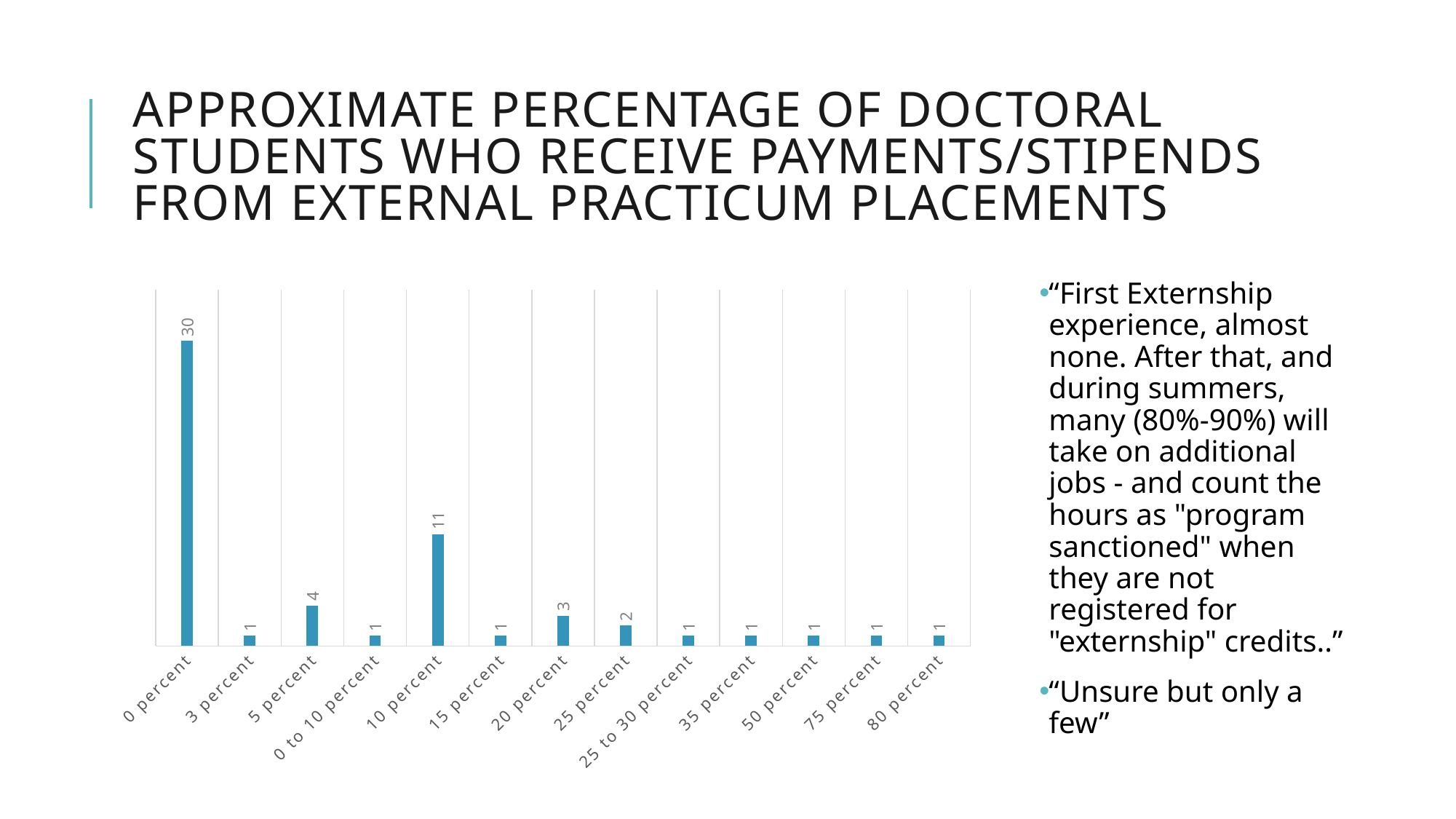
What is the value for the "0 percent" category? 30 What is the value for the "5 percent" category? 4 How many categories have a value of 1? 8 What is the value for the "25 percent" category? 2 What is the value for the "20 percent" category? 3 How many categories are shown on the x axis? 13 What is the value for the "10 percent" category? 11 What is the difference between the values for "5 percent" and "20 percent"? 1 Which category has the highest value? 0 percent What is the difference between the values for "0 percent" and "10 percent"? 19 What kind of chart is shown on the slide? Bar chart Which is larger, the value for "10 percent" or the value for "5 percent"? 10 percent